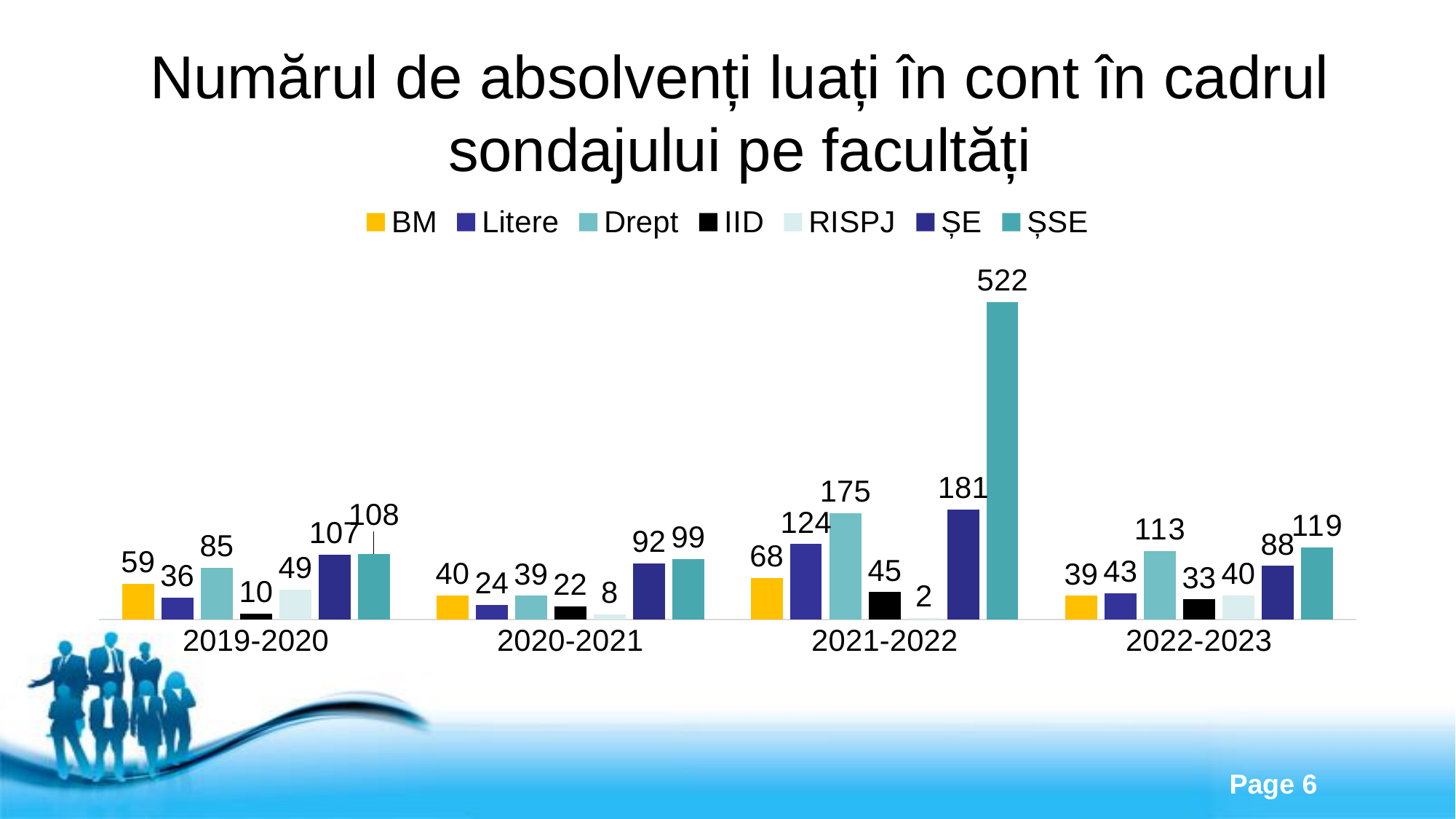
What kind of chart is shown on the slide? bar chart What is the value for Drept in 2022-2023? 113 What is the value for ȘSE in 2021-2022? 522 What is the title of the chart? Numărul de absolvenți luați în cont în cadrul sondajului pe facultăți How many academic years are shown on the x axis? 4 What is the value for RISPJ in 2020-2021? 8 Which series has the lowest value in 2021-2022? RISPJ Which series has the highest value in 2019-2020? ȘSE How many series does the legend list? 7 What is the difference between the ȘSE and ȘE values in 2021-2022? 341 Which is larger in 2022-2023, the value for BM or the value for Litere? Litere How does the value for Drept change from 2019-2020 to 2020-2021? It falls (from 85 to 39)